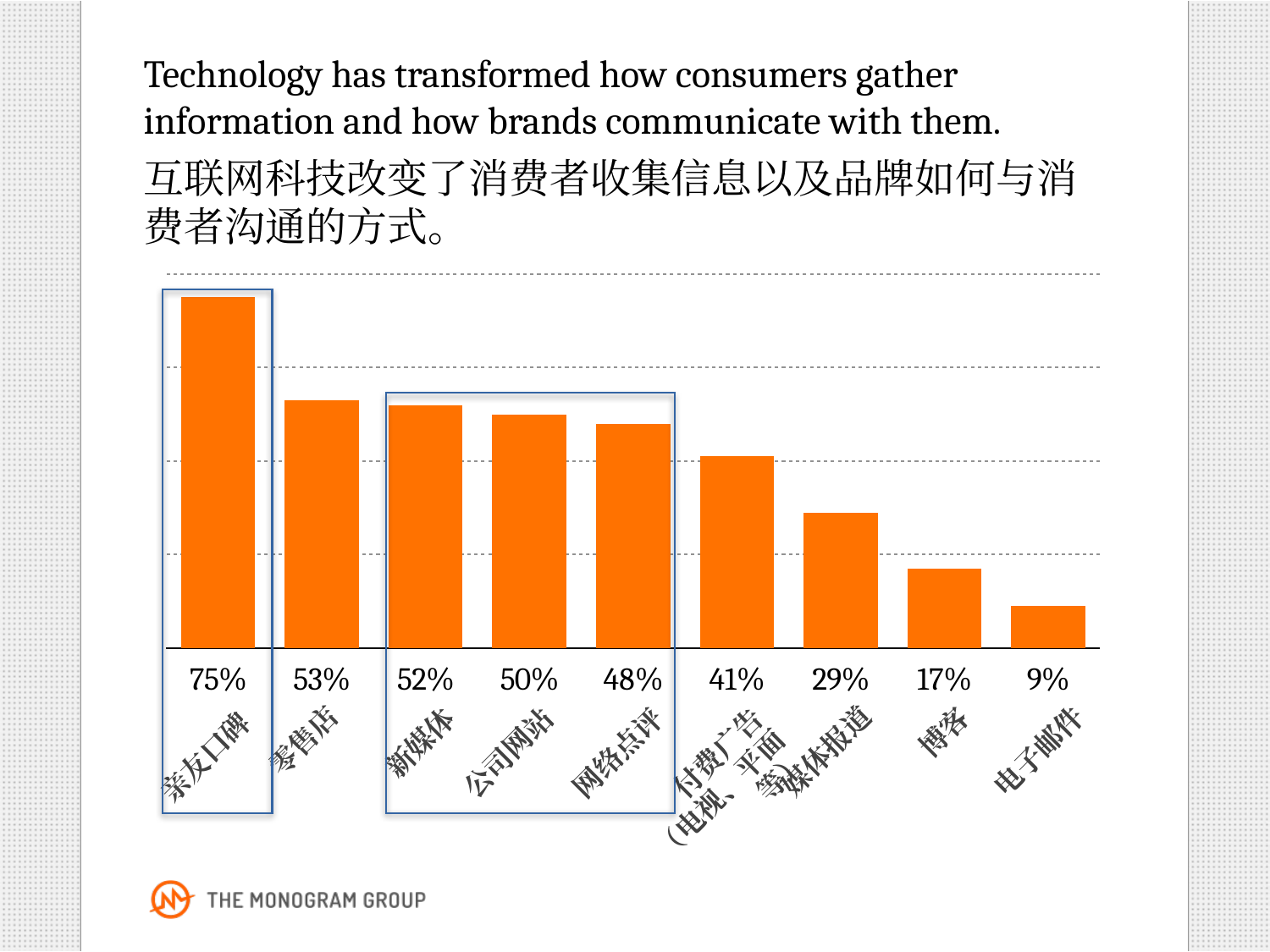
What kind of chart is shown on the slide? bar chart What is the difference between the values for 亲友口碑 and 零售店? 22% What is the value for 亲友口碑? 75% How many categories are shown in the bar chart? 9 What colour are the bars in the chart? orange What is the difference between the values for 媒体报道 and 电子邮件? 20% Which category has the lowest value? 电子邮件 Which category has the highest value? 亲友口碑 Which is larger, the value for 网络点评 or the value for 付费广告(电视、平面等)? 网络点评 What is the value for 公司网站? 50% What is the value for 博客? 17% Do the values rise or fall from left to right along the x axis? fall